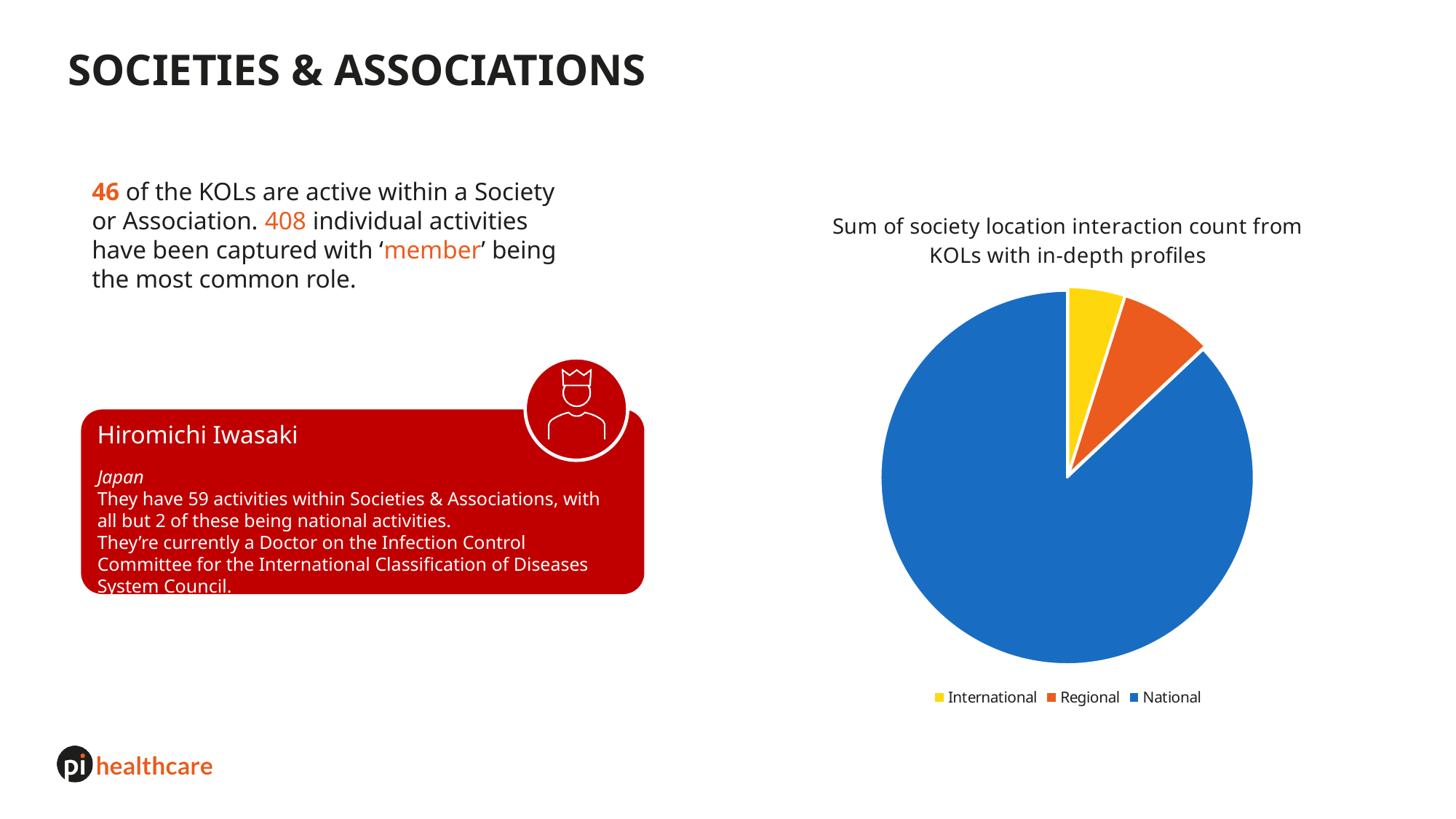
Which slice is larger in the pie chart, Regional or International? Regional Which colour represents the National category in the pie chart? blue Which slice is larger in the pie chart, National or Regional? National Which category has the largest slice in the pie chart? National What kind of chart is shown on the slide? pie chart What is the title of the pie chart? Sum of society location interaction count from KOLs with in-depth profiles How many slices does the pie chart have? 3 Does the National slice make up more or less than half of the pie chart? more How many categories does the pie chart's legend list? 3 Which category has the smallest slice in the pie chart? International